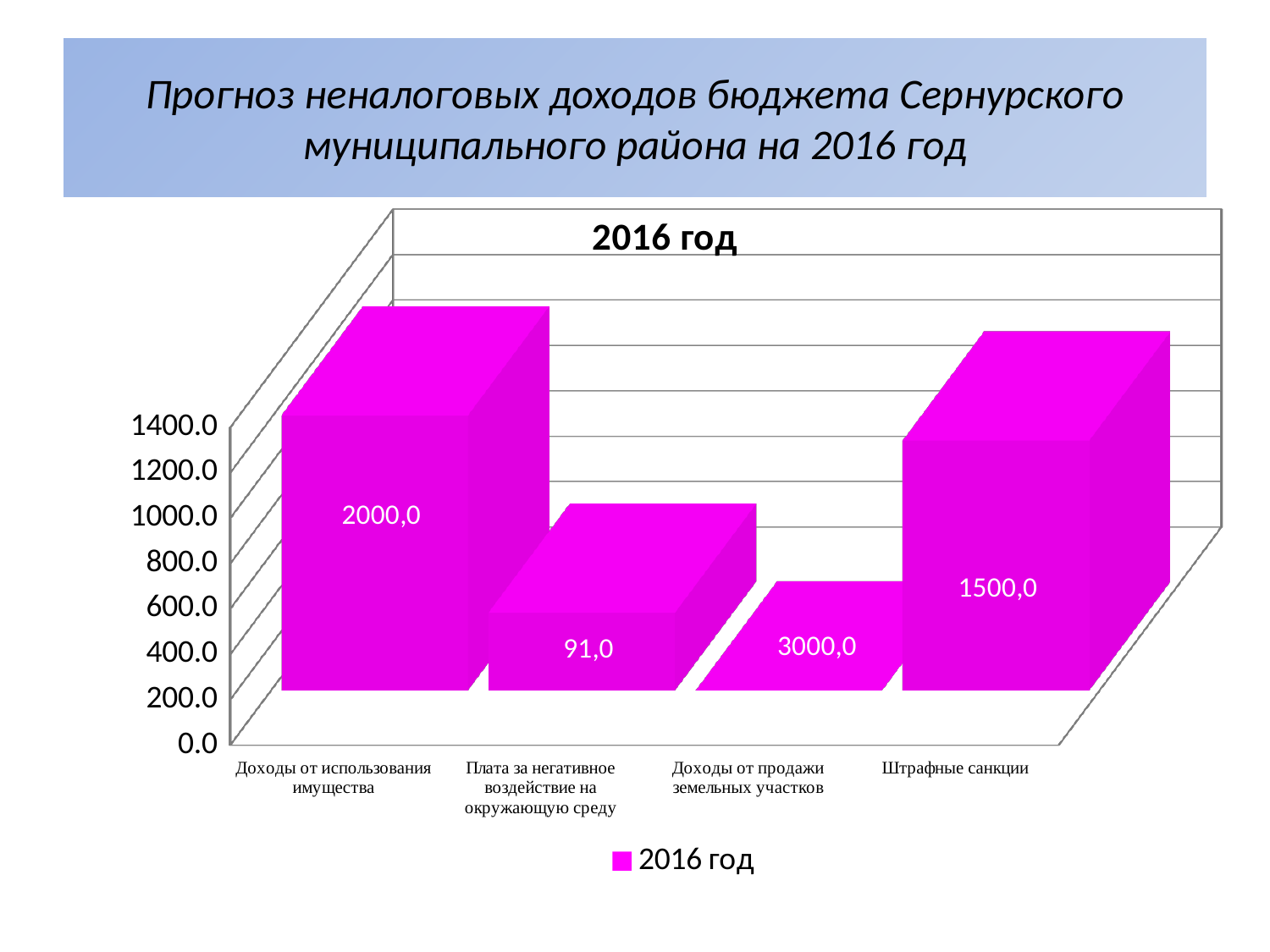
What is the value for Доходы от использования имущества? 2000,0 What is the difference between the labelled values for Доходы от использования имущества and Штрафные санкции? 500,0 What is the title of the chart? 2016 год What is the difference between the labelled values for Доходы от продажи земельных участков and Плата за негативное воздействие на окружающую среду? 2909,0 What is the value for Плата за негативное воздействие на окружающую среду? 91,0 What is the value for Доходы от продажи земельных участков? 3000,0 How many series does the legend list? 1 What kind of chart is shown on the slide? Bar chart What colour are the bars in the chart? Magenta How many categories are shown on the x axis? 4 What is the value for Штрафные санкции? 1500,0